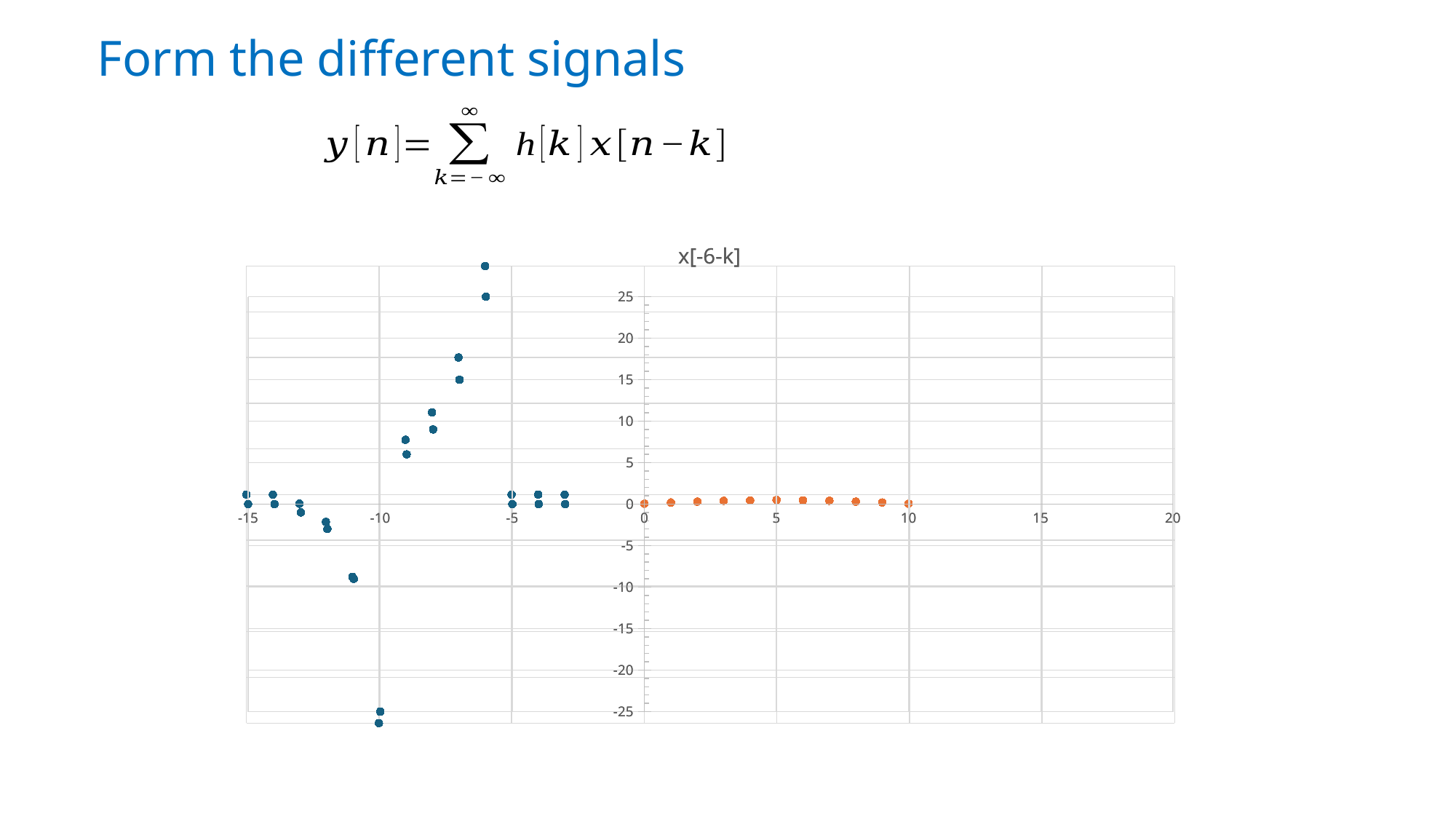
At which x value does the chart reach its lowest plotted point? -10 At which x value does the chart reach its highest plotted point? -6 What is the title of the chart? x[-6-k] Do the blue points rise or fall as x goes from -10 to -6? rise Is the value plotted at x = -11 greater or less than -5? less What kind of chart is shown on the slide? scatter chart Is the upper value plotted at x = -7 greater or less than 10? greater Which has the larger plotted value, the point at x = -6 or the point at x = -10? x = -6 What colour are the points plotted between x = 0 and x = 10? orange Which has the larger plotted value, the point at x = -7 or the point at x = -8? x = -7